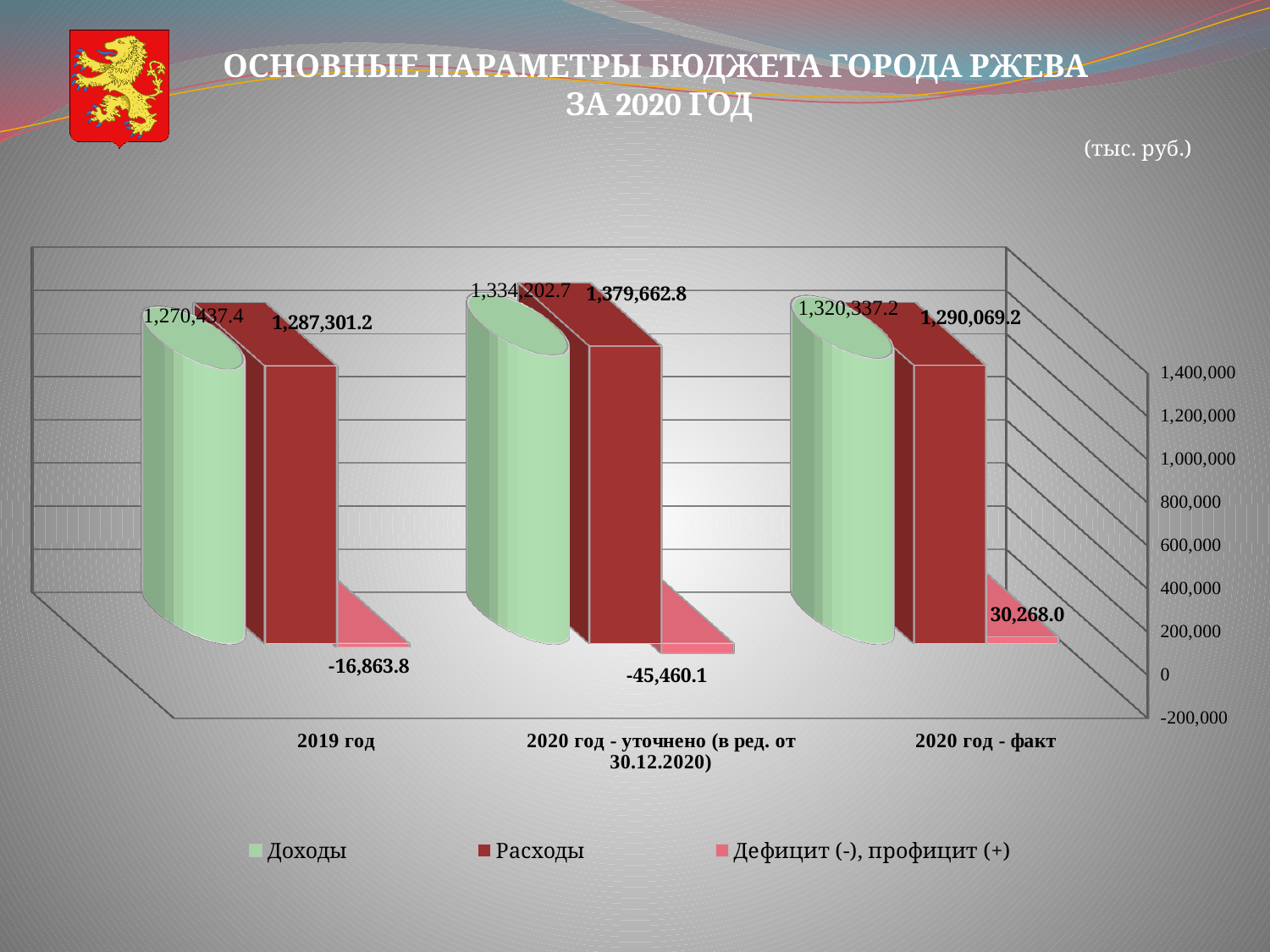
What unit is indicated for the chart values? тыс. руб. How many series does the legend list? 3 What is the difference between Расходы and Доходы for 2019 год? 16,863.8 Which category has the highest value of Расходы? 2020 год - уточнено (в ред. от 30.12.2020) How many categories are shown on the x axis? 3 What is the value of Доходы for 2019 год? 1,270,437.4 What kind of chart is shown on the slide? Bar chart Which category has the lowest value of Доходы? 2019 год What is the value of Расходы for 2020 год - уточнено (в ред. от 30.12.2020)? 1,379,662.8 What is the value of Дефицит (-), профицит (+) for 2020 год - факт? 30,268.0 For 2020 год - факт, which is larger: Доходы or Расходы? Доходы What is the value of Доходы for 2020 год - факт? 1,320,337.2